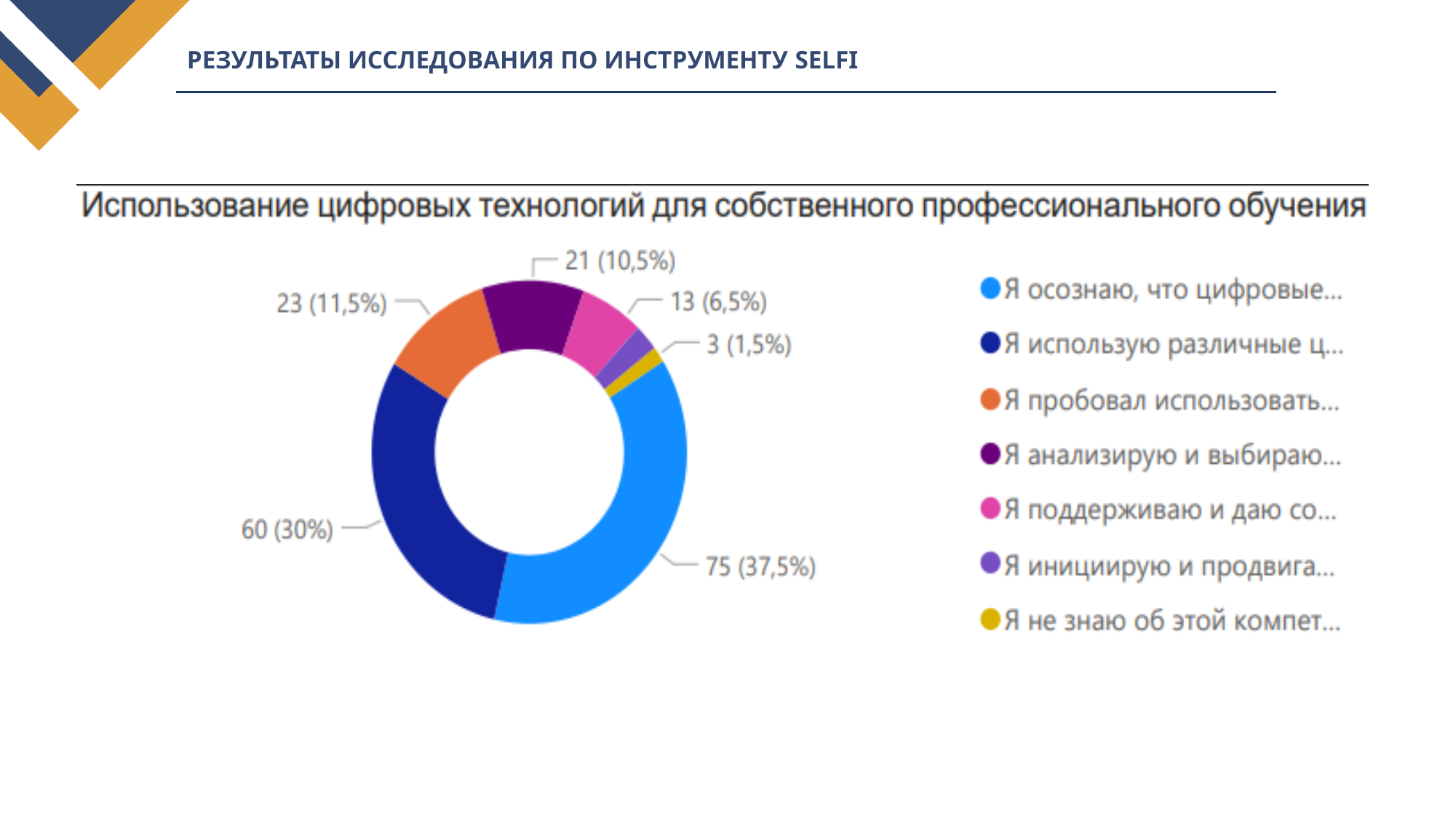
What value is shown for the yellow slice ("Я не знаю об этой компет...")? 3 (1,5%) What value is shown for the light blue slice ("Я осознаю, что цифровые...")? 75 (37,5%) What is the title of the chart? Использование цифровых технологий для собственного профессионального обучения What value is shown for the dark blue slice ("Я использую различные ц...")? 60 (30%) Which legend category has the smallest labelled slice of the chart? Я не знаю об этой компет... What share of the chart does the pink slice ("Я поддерживаю и даю со...") represent? 6,5% How many entries does the legend of the chart list? 7 What value is shown for the orange slice ("Я пробовал использовать...")? 23 (11,5%) What is the difference in count between the light blue slice (75) and the dark blue slice (60)? 15 What value is shown for the dark purple slice ("Я анализирую и выбираю...")? 21 (10,5%) What kind of chart is shown on the slide? Donut (pie) chart Which legend category has the largest slice of the chart? Я осознаю, что цифровые...